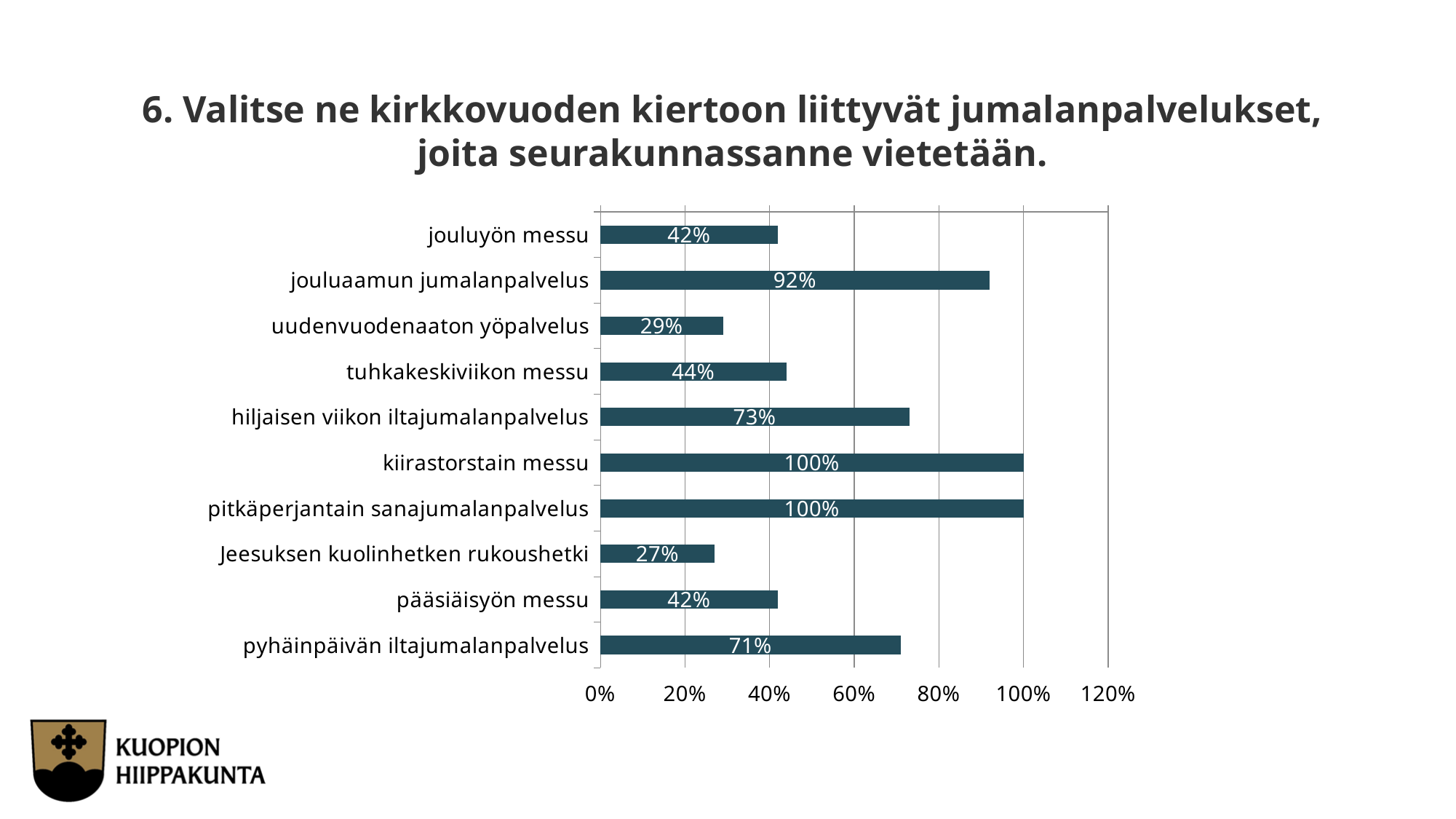
Which category has the lowest value? Jeesuksen kuolinhetken rukoushetki What kind of chart is shown on the slide? bar chart Which is larger, the value for hiljaisen viikon iltajumalanpalvelus or the value for pyhäinpäivän iltajumalanpalvelus? hiljaisen viikon iltajumalanpalvelus What is the value for pyhäinpäivän iltajumalanpalvelus? 71% How many categories have a value of 100%? 2 What is the value for hiljaisen viikon iltajumalanpalvelus? 73% What is the difference between the values for tuhkakeskiviikon messu and uudenvuodenaaton yöpalvelus? 15% Is the value for jouluaamun jumalanpalvelus greater or less than 80%? greater How many categories are shown in the chart? 10 What is the value for uudenvuodenaaton yöpalvelus? 29% What is the value for jouluaamun jumalanpalvelus? 92% What is the difference between the values for jouluaamun jumalanpalvelus and jouluyön messu? 50%